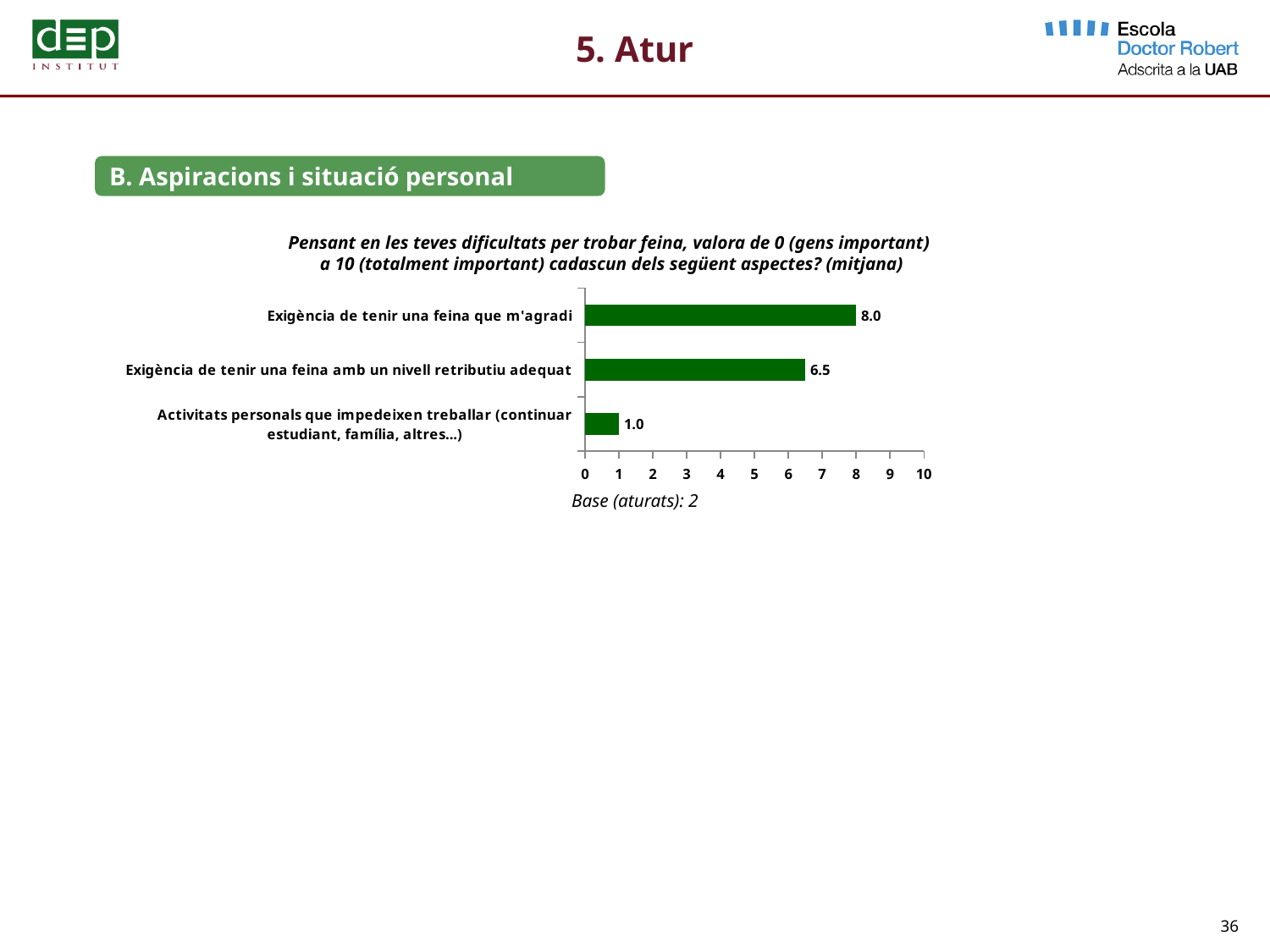
Which category has the highest value? Exigència de tenir una feina que m'agradi What kind of chart is shown on the slide? Bar chart Which category has the lowest value? Activitats personals que impedeixen treballar (continuar estudiant, família, altres...) What is the difference between the values for "Exigència de tenir una feina amb un nivell retributiu adequat" and "Activitats personals que impedeixen treballar (continuar estudiant, família, altres...)"? 5.5 Which is larger: the value for "Exigència de tenir una feina que m'agradi" or the value for "Exigència de tenir una feina amb un nivell retributiu adequat"? Exigència de tenir una feina que m'agradi How many categories are shown in the chart? 3 What is the difference between the values for "Exigència de tenir una feina que m'agradi" and "Exigència de tenir una feina amb un nivell retributiu adequat"? 1.5 Is the value for "Exigència de tenir una feina amb un nivell retributiu adequat" greater or less than 5? greater What is the value for "Activitats personals que impedeixen treballar (continuar estudiant, família, altres...)"? 1.0 What is the base (number of respondents) stated below the chart? 2 What is the value for "Exigència de tenir una feina amb un nivell retributiu adequat"? 6.5 What is the value for "Exigència de tenir una feina que m'agradi"? 8.0